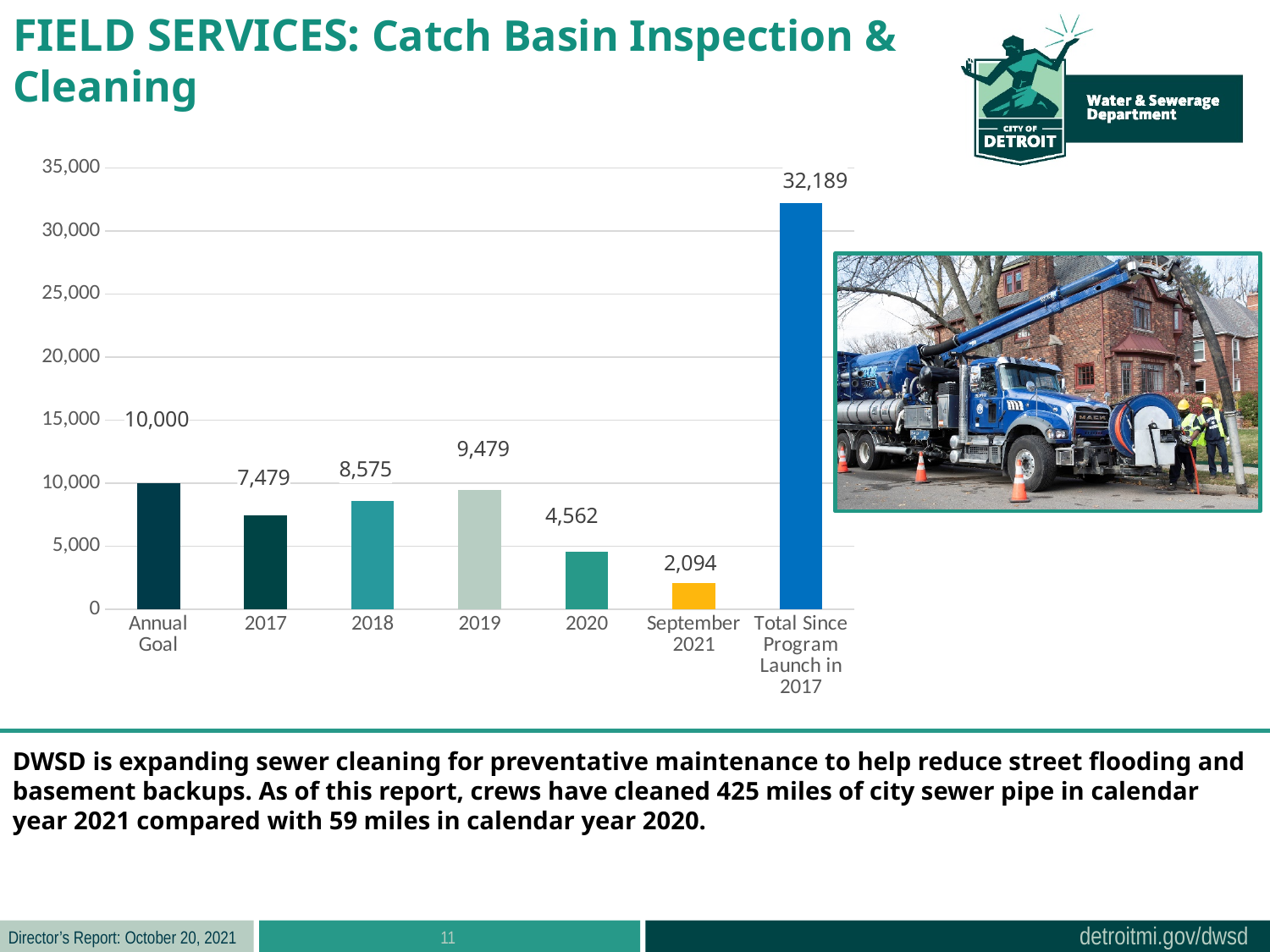
What is the difference between the 2019 value and the 2020 value? 4,917 What is the value for September 2021? 2,094 What is the value for the Annual Goal bar? 10,000 Which is larger, the value for 2017 or the value for 2018? 2018 What is the value for 2018? 8,575 Which category has the highest value? Total Since Program Launch in 2017 What kind of chart is shown on the slide? bar chart Do the values rise or fall from 2017 to 2019? rise How many bars are shown in the chart? 7 Is the value for 2020 greater or less than 5,000? less What is the value for Total Since Program Launch in 2017? 32,189 Which category has the lowest value? September 2021